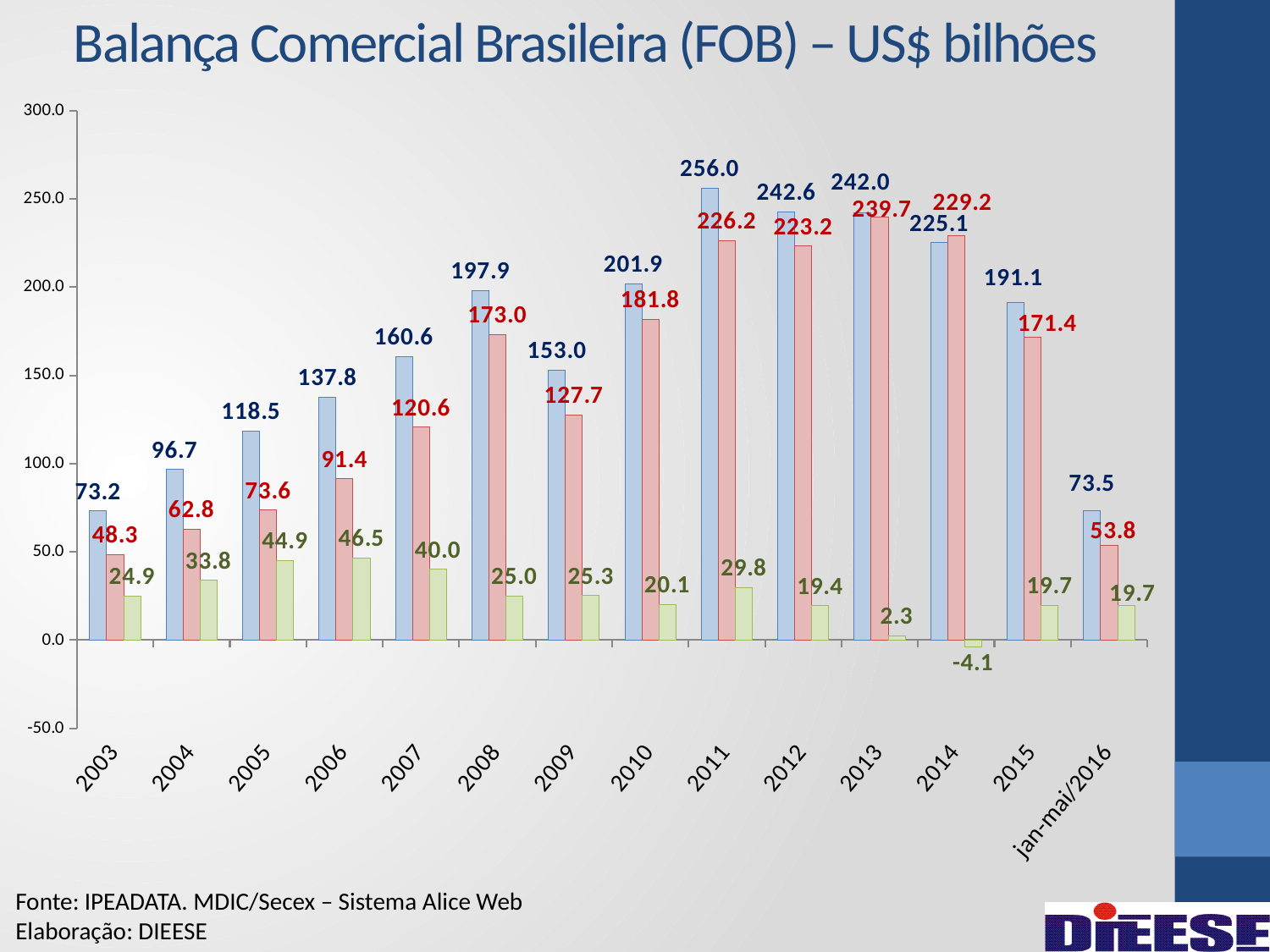
How many categories are shown on the x axis? 14 Which is larger for 2013, the blue bar or the red bar? the blue bar What is the value of the blue bar for 2011? 256.0 What is the difference between the blue bar and the red bar for 2011? 29.8 Which is larger for 2014, the blue bar or the red bar? the red bar What kind of chart is shown on the slide? bar chart In which year does the blue series reach its highest value? 2011 What is the value of the green bar for 2014? -4.1 In which year does the green series have its lowest value? 2014 What is the value of the blue bar for jan-mai/2016? 73.5 What is the value of the red bar for 2013? 239.7 What is the title of the chart? Balança Comercial Brasileira (FOB) – US$ bilhões